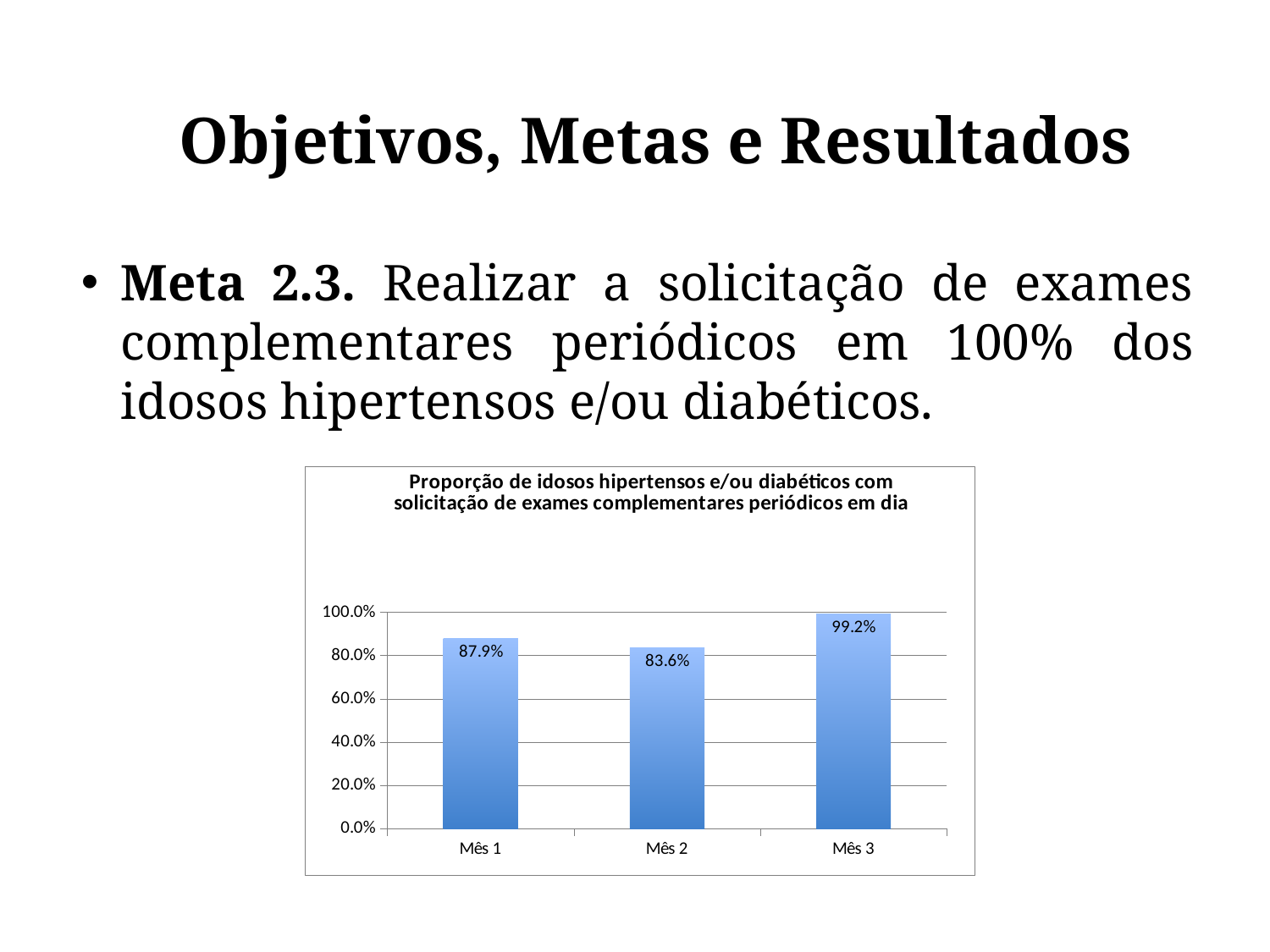
What is the value for Mês 2? 83.6% What is the value for Mês 3? 99.2% What is the title of the chart? Proporção de idosos hipertensos e/ou diabéticos com solicitação de exames complementares periódicos em dia What is the difference between the values for Mês 1 and Mês 2? 4.3% Which month has the highest value? Mês 3 Which month has the lowest value? Mês 2 What is the difference between the values for Mês 3 and Mês 2? 15.6% What is the value for Mês 1? 87.9% Which is larger, the value for Mês 1 or the value for Mês 2? Mês 1 How many months are shown on the x axis? 3 What kind of chart is shown on the slide? bar chart Is the value for Mês 3 greater or less than 80.0%? greater